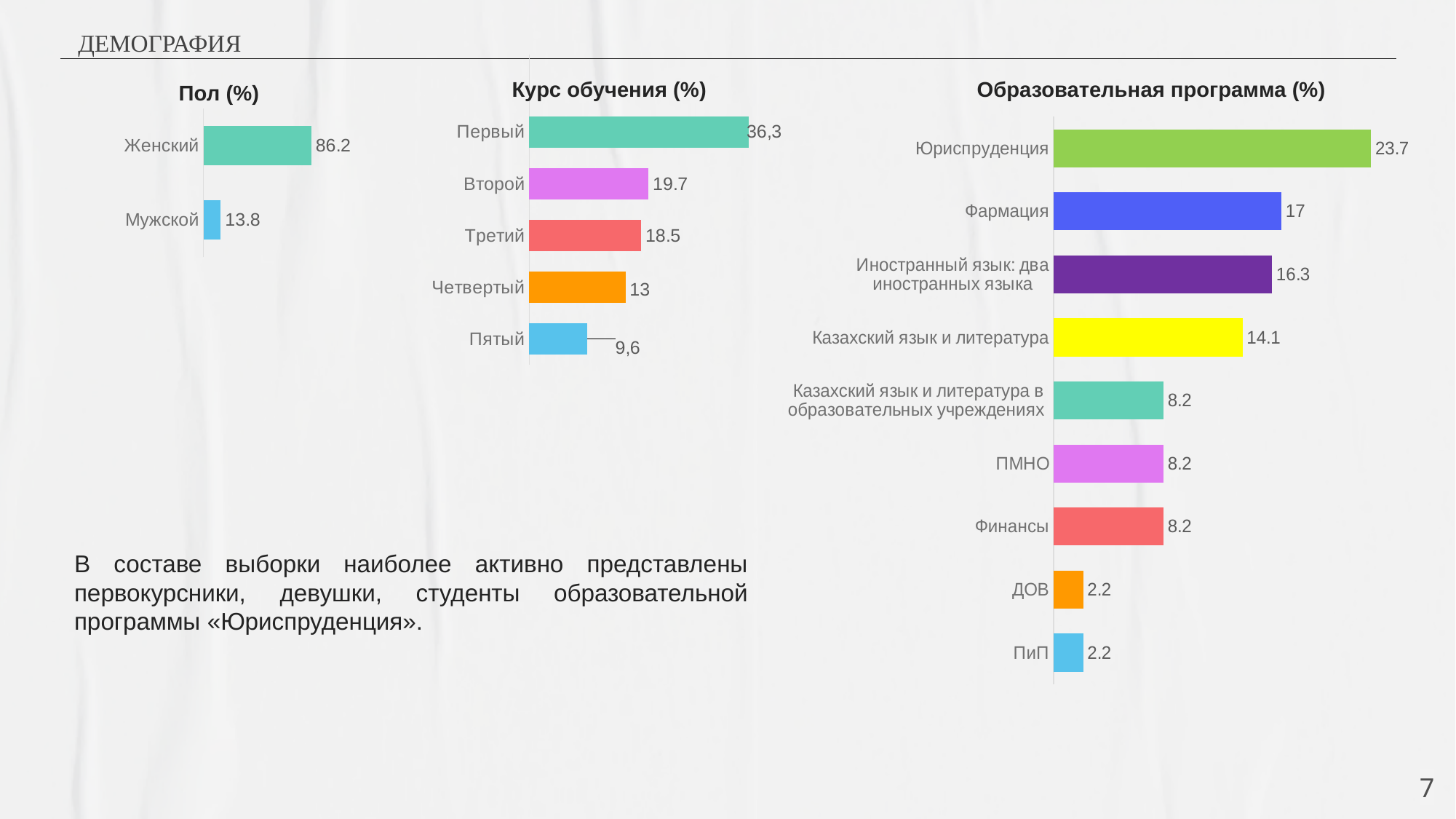
In the chart titled "Образовательная программа (%)", how many categories are shown? 9 In the chart titled "Образовательная программа (%)", what is the value for Фармация? 17 In the chart titled "Пол (%)", what is the difference between the values for Женский and Мужской? 72.4 In the chart titled "Курс обучения (%)", how many categories are shown? 5 In the chart titled "Образовательная программа (%)", what is the difference between the values for Юриспруденция and Фармация? 6.7 In the chart titled "Курс обучения (%)", which category has the highest value? Первый In the chart titled "Образовательная программа (%)", which is larger, the value for Казахский язык и литература or the value for Финансы? Казахский язык и литература In the chart titled "Курс обучения (%)", which category has the lowest value? Пятый In the chart titled "Пол (%)", what is the value for Женский? 86.2 What kind of chart is the chart titled "Пол (%)"? Bar chart In the chart titled "Курс обучения (%)", what is the value for Третий? 18.5 In the chart titled "Образовательная программа (%)", which category has the highest value? Юриспруденция